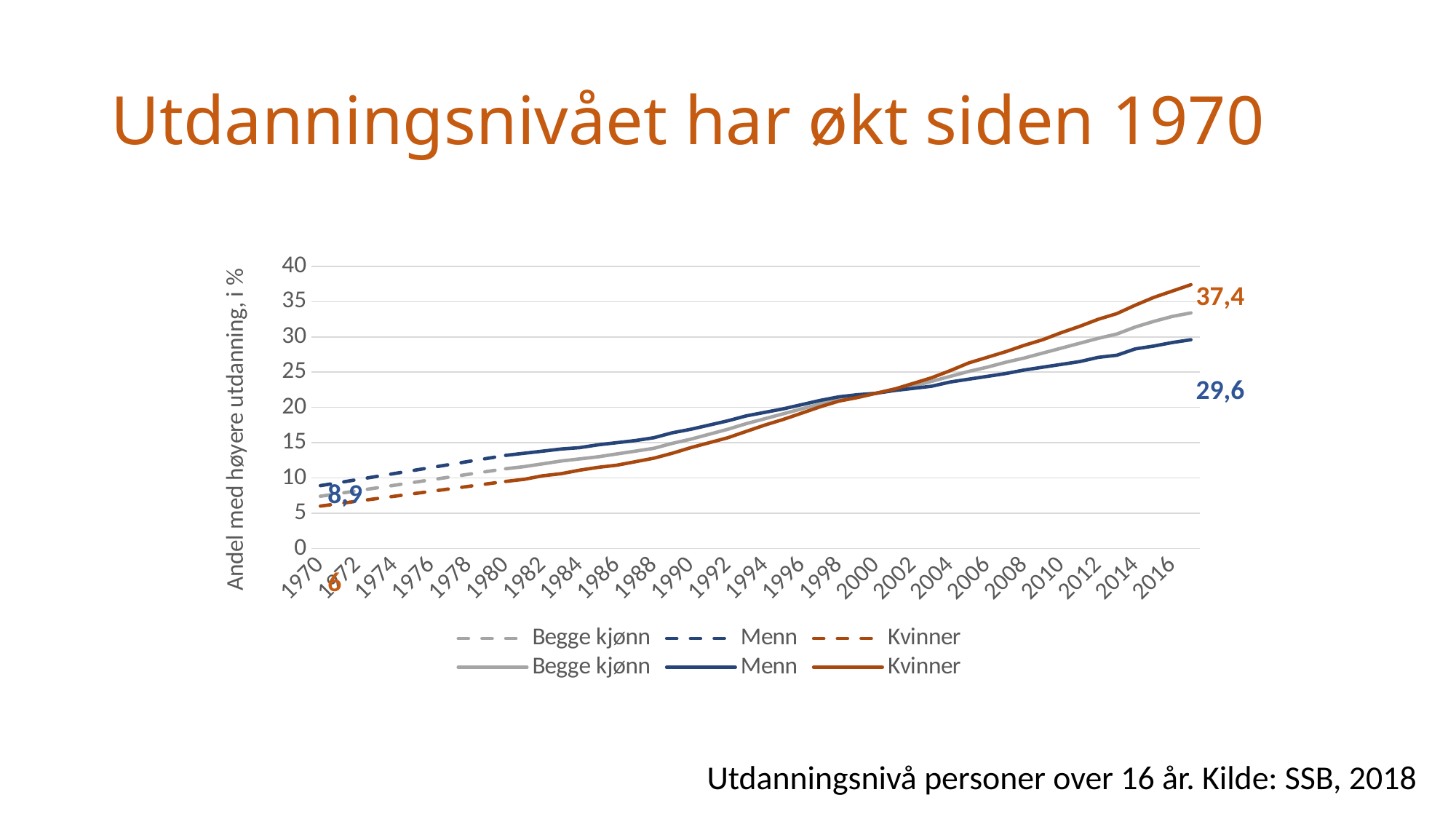
Which series has the lowest value in 1970? Kvinner What is the value shown for Menn at the end of the series (2017)? 29,6 Which series has the highest value at the end of the chart? Kvinner What is the value shown for Kvinner at the end of the series (2017)? 37,4 Is the value for Begge kjønn in 2016 greater or less than 30? greater What kind of chart is shown on the slide? line chart What is the value shown for Menn in 1970? 8,9 What is the value shown for Kvinner in 1970? 6 What is the difference between the final values for Kvinner (37,4) and Menn (29,6)? 7,8 Do the values for Kvinner rise or fall from 1970 to 2017? rise In 1970, which is larger: the value for Menn or the value for Kvinner? Menn What is the title of the vertical axis? Andel med høyere utdanning, i %